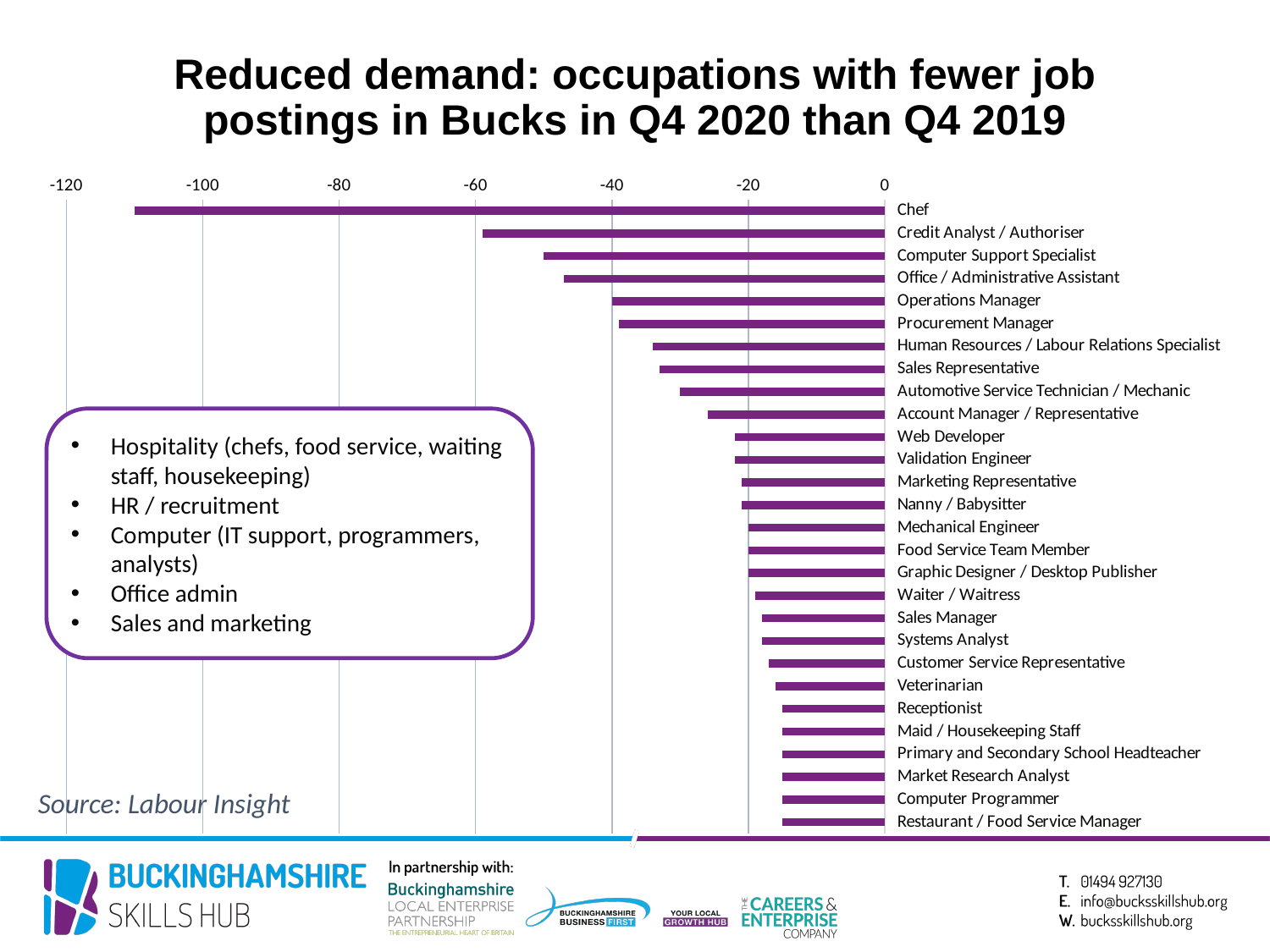
Is the value for Human Resources / Labour Relations Specialist greater or less than -40? greater Which has the larger reduction in job postings, Computer Support Specialist or Sales Representative? Computer Support Specialist Which has the larger reduction in job postings, Chef or Credit Analyst / Authoriser? Chef Is the value for Chef greater or less than -100? less Which occupation has the largest reduction in job postings (the longest bar)? Chef How many occupations are listed on the chart? 28 Is the value for Computer Support Specialist greater or less than -40? less What is the title of the chart? Reduced demand: occupations with fewer job postings in Bucks in Q4 2020 than Q4 2019 Going down the chart from Chef to Restaurant / Food Service Manager, do the bars get longer or shorter? Shorter What kind of chart is shown on the slide? Bar chart